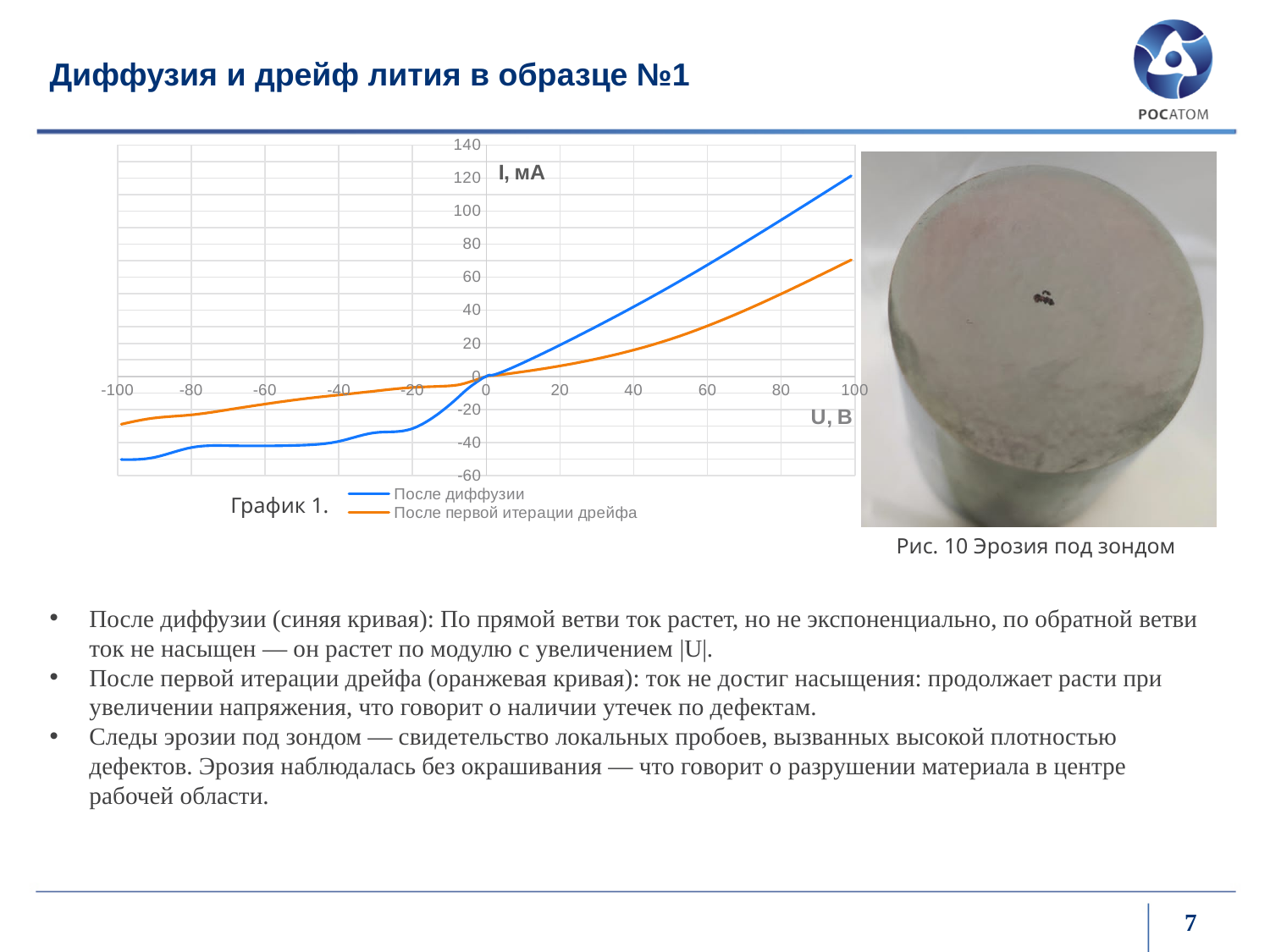
Is the value of the orange 'После первой итерации дрейфа' curve at U = 100 greater or less than 80? less How many series does the chart legend list? 2 Is the value of the orange 'После первой итерации дрейфа' curve at U = 100 greater or less than 60? greater At U = -100, which series has the lower (more negative) current: 'После диффузии' or 'После первой итерации дрейфа'? После диффузии Does the current of the 'После диффузии' curve rise or fall as U increases from -100 to 100? rise What is the label of the vertical axis of the chart? I, мА Is the value of the blue 'После диффузии' curve at U = 100 greater or less than 100? greater At U = 100, which series has the higher current: 'После диффузии' or 'После первой итерации дрейфа'? После диффузии What are the two series named in the chart legend? После диффузии; После первой итерации дрейфа What kind of chart is shown on the slide? line chart